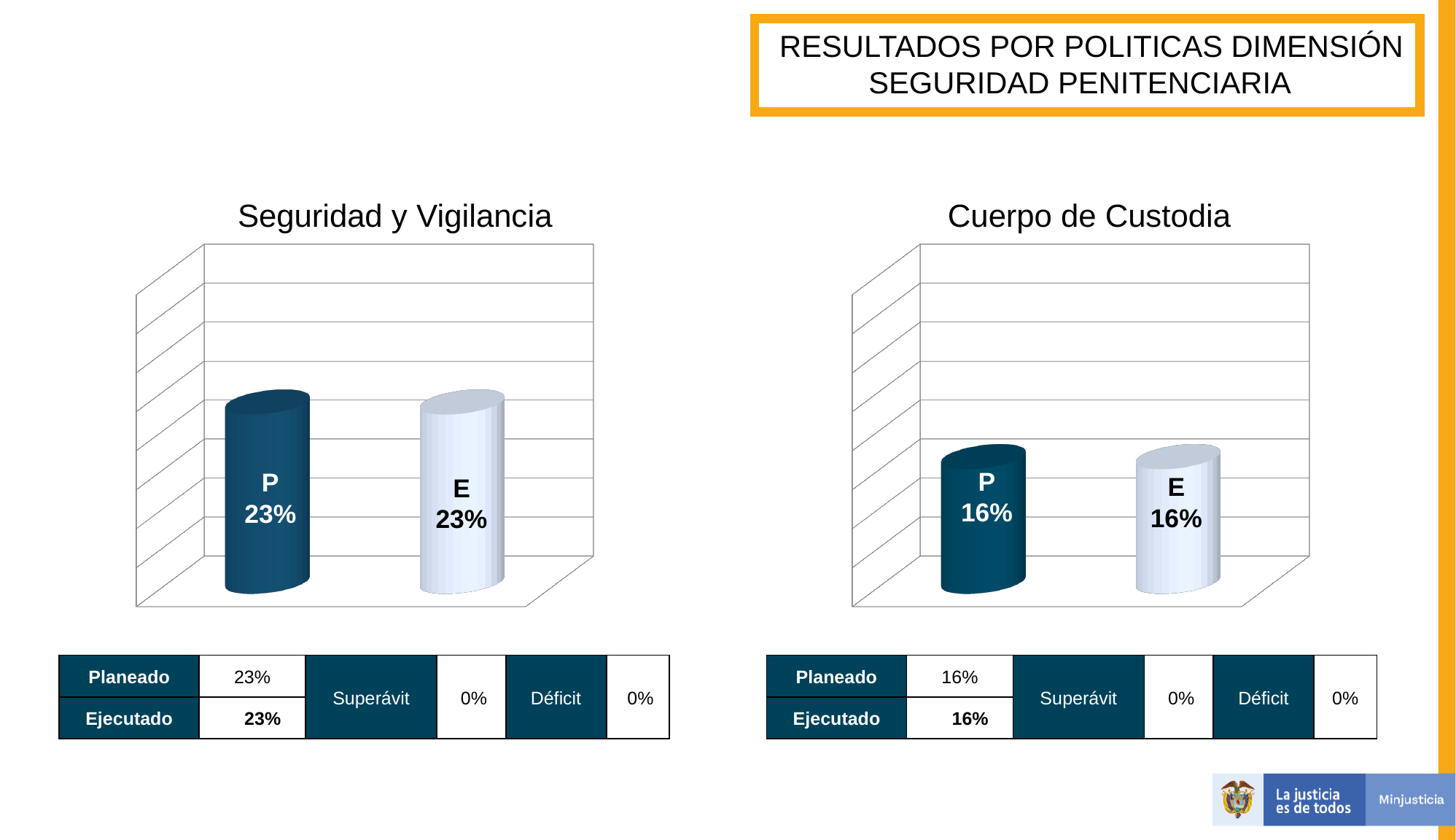
What kind of chart is the Seguridad y Vigilancia chart? Bar chart What is the difference between the E value in the Seguridad y Vigilancia chart and the E value in the Cuerpo de Custodia chart? 7% In the Seguridad y Vigilancia chart, what is the value of the P bar? 23% What is the title of the chart on the right side of the slide? Cuerpo de Custodia In the Cuerpo de Custodia chart, what is the difference between the P and E values? 0% How many bars are plotted in the Cuerpo de Custodia chart? 2 In the Seguridad y Vigilancia chart, what is the value of the E bar? 23% In the Seguridad y Vigilancia chart, what is the difference between the P and E values? 0% Which chart has the higher P value, Seguridad y Vigilancia or Cuerpo de Custodia? Seguridad y Vigilancia In the Cuerpo de Custodia chart, what is the value of the P bar? 16% What is the title of the chart on the left side of the slide? Seguridad y Vigilancia In the Cuerpo de Custodia chart, what is the value of the E bar? 16%